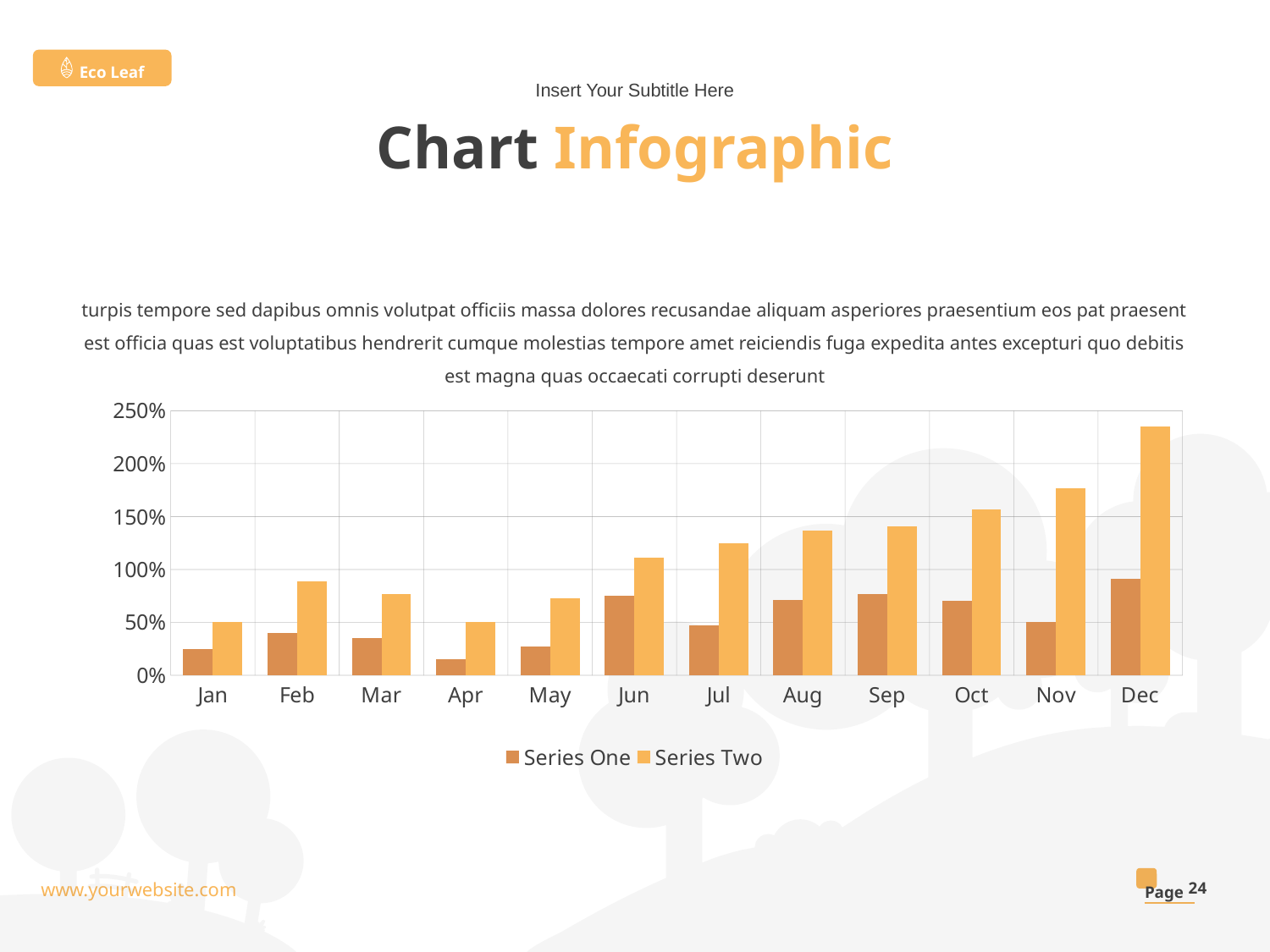
Is the Series One value for Jan greater or less than 50%? less Which is larger in Jan, the Series One value or the Series Two value? Series Two What kind of chart is shown on the slide? bar chart How many series does the chart's legend list? 2 In which month is the Series One value highest? Dec Is the Series Two value for Nov greater or less than 150%? greater In which month is the Series One value lowest? Apr How many months are shown on the x axis of the chart? 12 In which month is the Series Two value highest? Dec What are the names of the series in the legend? Series One and Series Two Is the Series Two value for Dec greater or less than 200%? greater Does the Series Two value rise or fall from Jun to Dec? rise